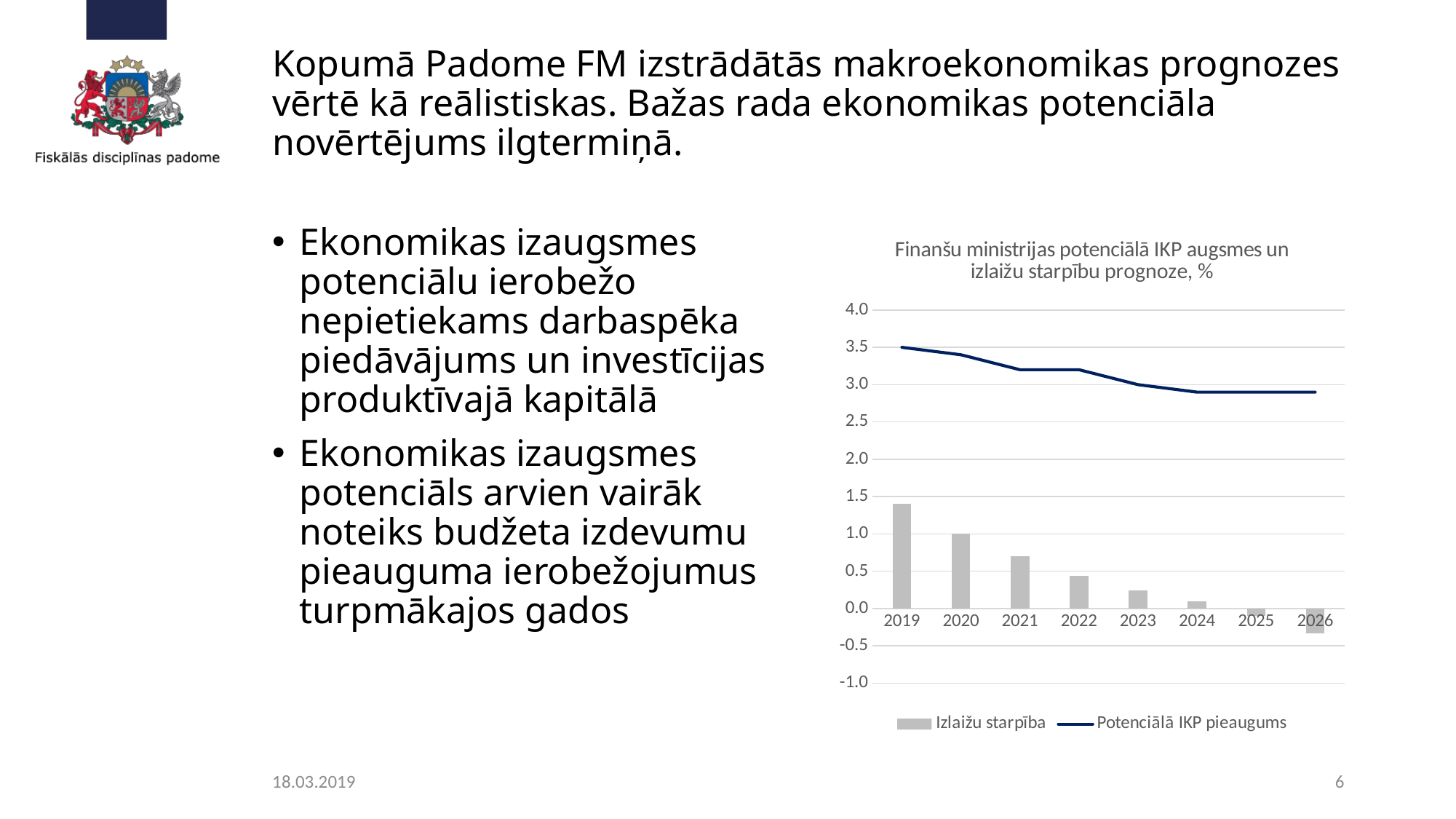
What is the title of the chart? Finanšu ministrijas potenciālā IKP augsmes un izlaižu starpību prognoze, % Which year has the larger Izlaižu starpība bar, 2019 or 2022? 2019 Is the Izlaižu starpība value for 2026 greater or less than 0.0? less How many series does the chart legend list? 2 Which year has the lowest bar for Izlaižu starpība? 2026 Is the Izlaižu starpība value for 2019 greater or less than 1.0? greater How many years are shown on the x axis of the chart? 8 What kind of chart is shown on the slide? A combined bar and line chart Does the Potenciālā IKP pieaugums line rise or fall from 2019 to 2026? Falls Which year has the highest bar for Izlaižu starpība? 2019 Is the Potenciālā IKP pieaugums value for 2021 greater or less than 3.0? greater